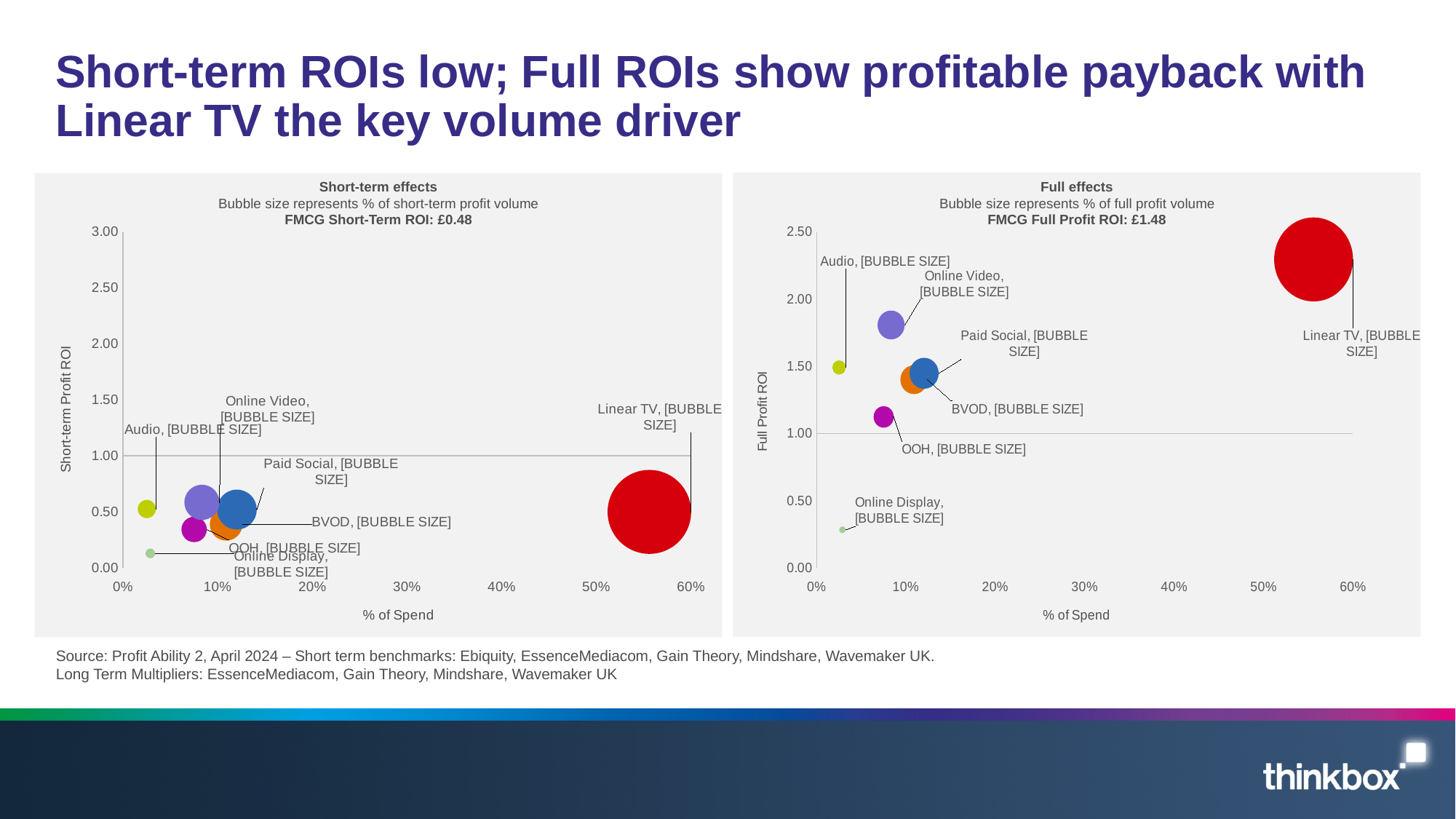
On the 'Full effects' chart, which channel has the highest Full Profit ROI? Linear TV On the 'Full effects' chart, is the Full Profit ROI for Linear TV greater or less than 2.00? greater On the 'Full effects' chart, which has the higher Full Profit ROI, Online Video or OOH? Online Video On the 'Short-term effects' chart, which channel has the lowest Short-term Profit ROI? Online Display What kind of chart is the 'Short-term effects' chart? bubble chart On the 'Short-term effects' chart, which channel has the largest bubble? Linear TV What FMCG Full Profit ROI is stated in the title of the 'Full effects' chart? £1.48 On the 'Short-term effects' chart, is the Short-term Profit ROI for Linear TV greater or less than 1.00? less On the 'Full effects' chart, is the Full Profit ROI for Online Display greater or less than 0.50? less How many media channels (bubbles) are plotted on the 'Full effects' chart? 7 On the 'Full effects' chart, which channel has the lowest Full Profit ROI? Online Display